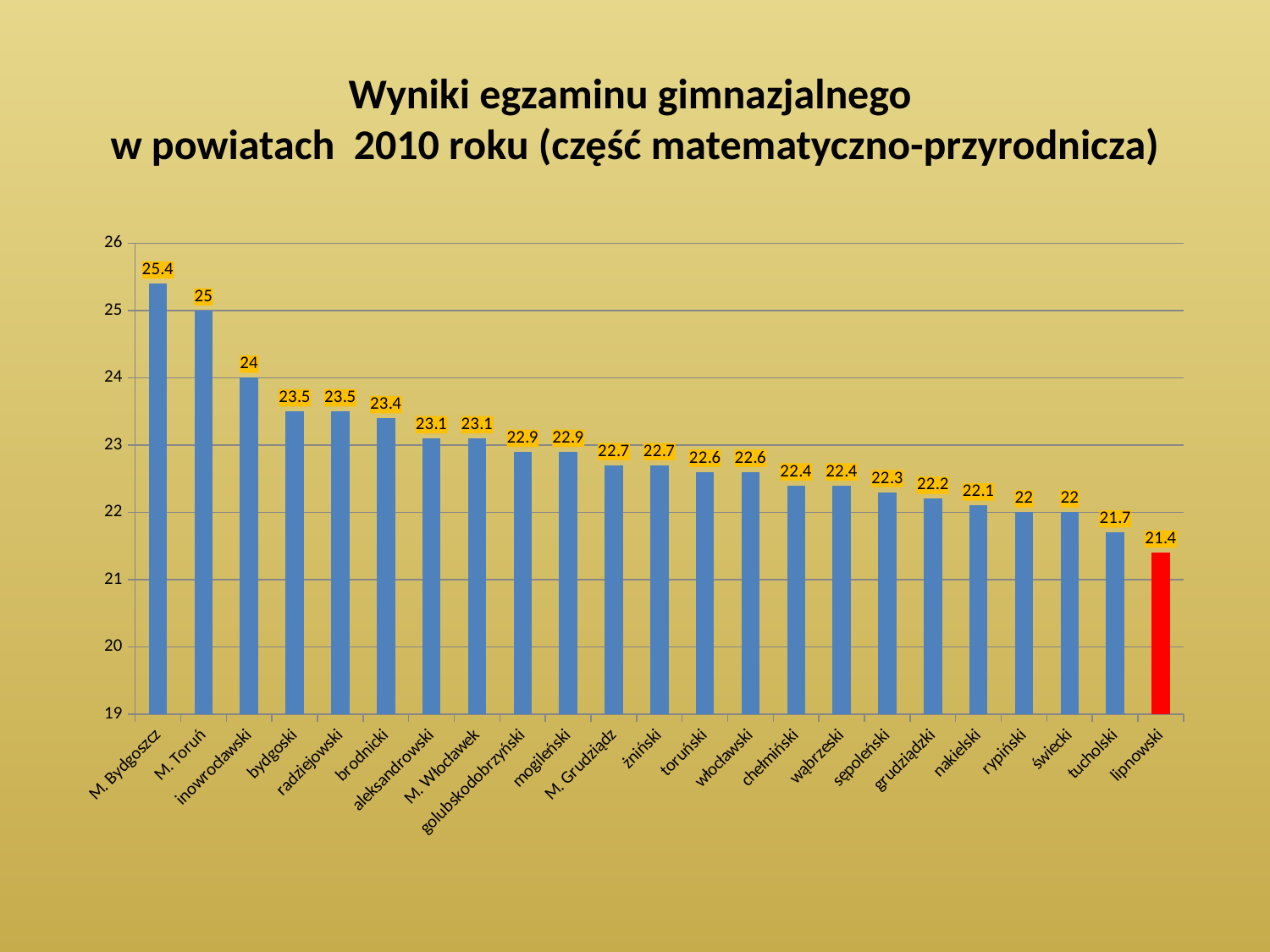
What is the value for sępoleński? 22.3 How many categories are shown on the x axis? 23 Which category has the lowest value? lipnowski What kind of chart is this? Bar chart Which category's bar is coloured red instead of blue? lipnowski Which category has the highest value? M. Bydgoszcz What is the value for M. Bydgoszcz? 25.4 Which has a larger value, M. Toruń or nakielski? M. Toruń What is the value for lipnowski? 21.4 What is the value for brodnicki? 23.4 What is the difference between the values for M. Bydgoszcz and lipnowski? 4 What is the difference between the values for inowrocławski and tucholski? 2.3